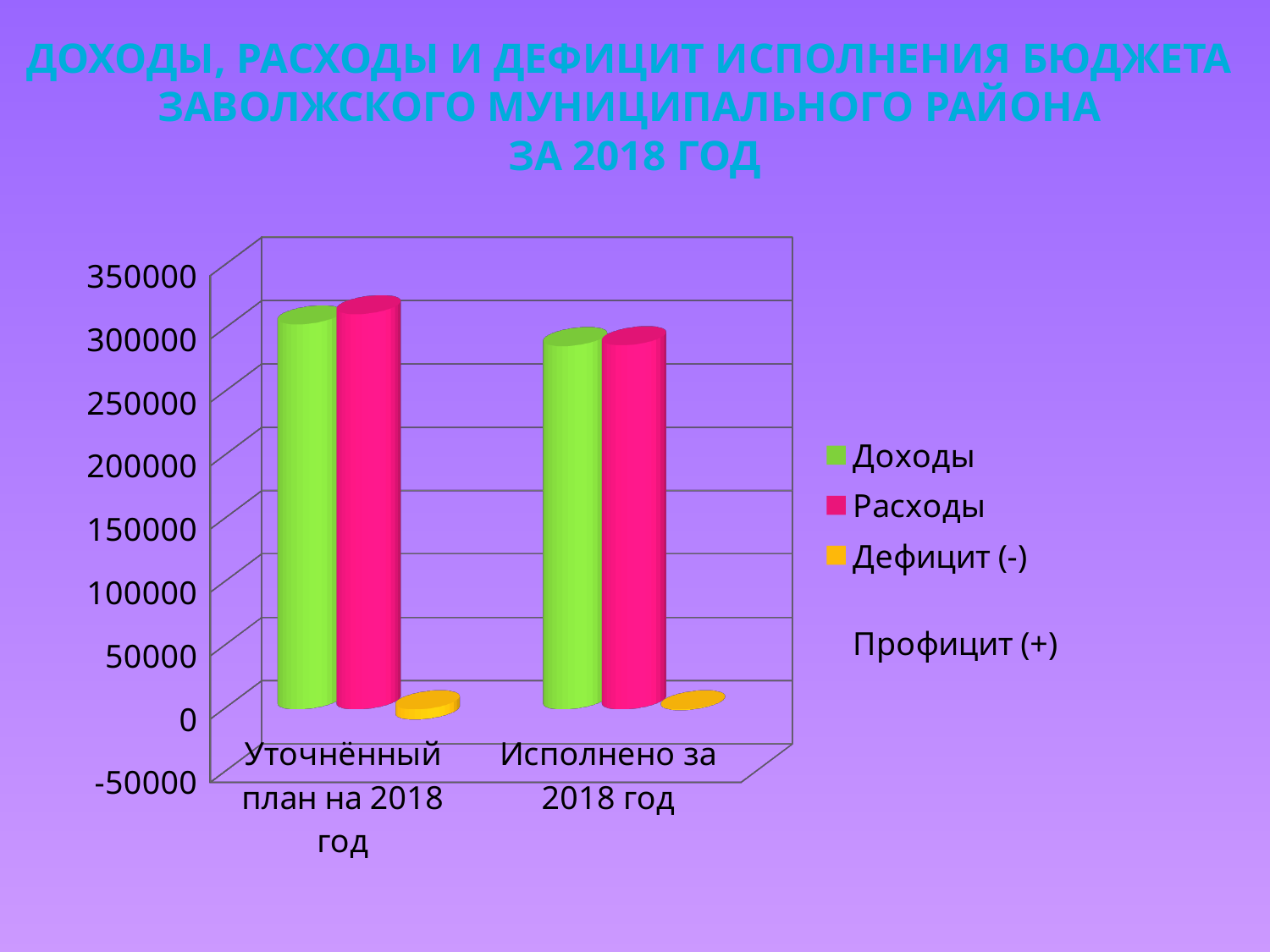
What colour are the bars for the Доходы series? green Does the value of Доходы rise or fall from 'Уточнённый план на 2018 год' to 'Исполнено за 2018 год'? fall What is the highest value labelled on the vertical axis of the chart? 350000 Which series has the lowest value in the 'Исполнено за 2018 год' category? Дефицит (-) In the 'Уточнённый план на 2018 год' category, which is larger: Доходы or Расходы? Расходы Which series has the tallest bar in the 'Уточнённый план на 2018 год' category? Расходы Is the value of Расходы for 'Уточнённый план на 2018 год' greater or less than 250000? greater Is the value of Дефицит (-) for 'Исполнено за 2018 год' greater or less than 50000? less Is the value of Доходы for 'Исполнено за 2018 год' greater or less than 250000? greater Does the value of Расходы rise or fall from 'Уточнённый план на 2018 год' to 'Исполнено за 2018 год'? fall What kind of chart is shown on the slide? bar chart How many categories are shown on the x axis of the chart? 2